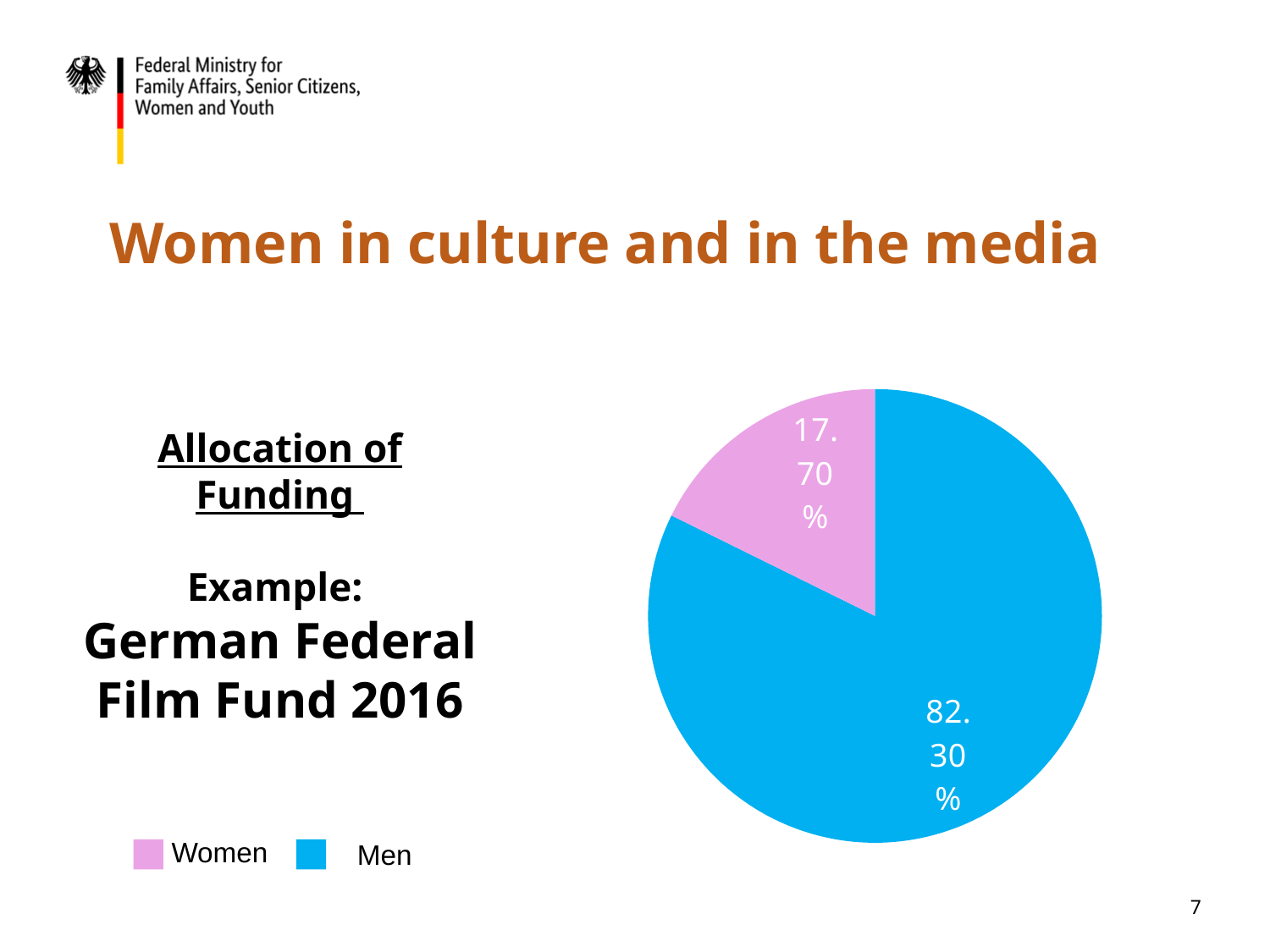
Which group received the largest share of funding in the pie chart? Men What share of the German Federal Film Fund 2016 funding went to men? 82.30% What is the difference in percentage points between the men's and women's shares of funding? 64.60 How many slices does the pie chart have? 2 Which slice is larger, Women or Men? Men Is the share of funding for women greater or less than 20%? less Which group received the smallest share of funding in the pie chart? Women How many entries does the legend list? 2 What colour represents Women in the pie chart? Pink What colour represents Men in the pie chart? Blue What kind of chart is shown on the slide? Pie chart What share of the German Federal Film Fund 2016 funding went to women? 17.70%